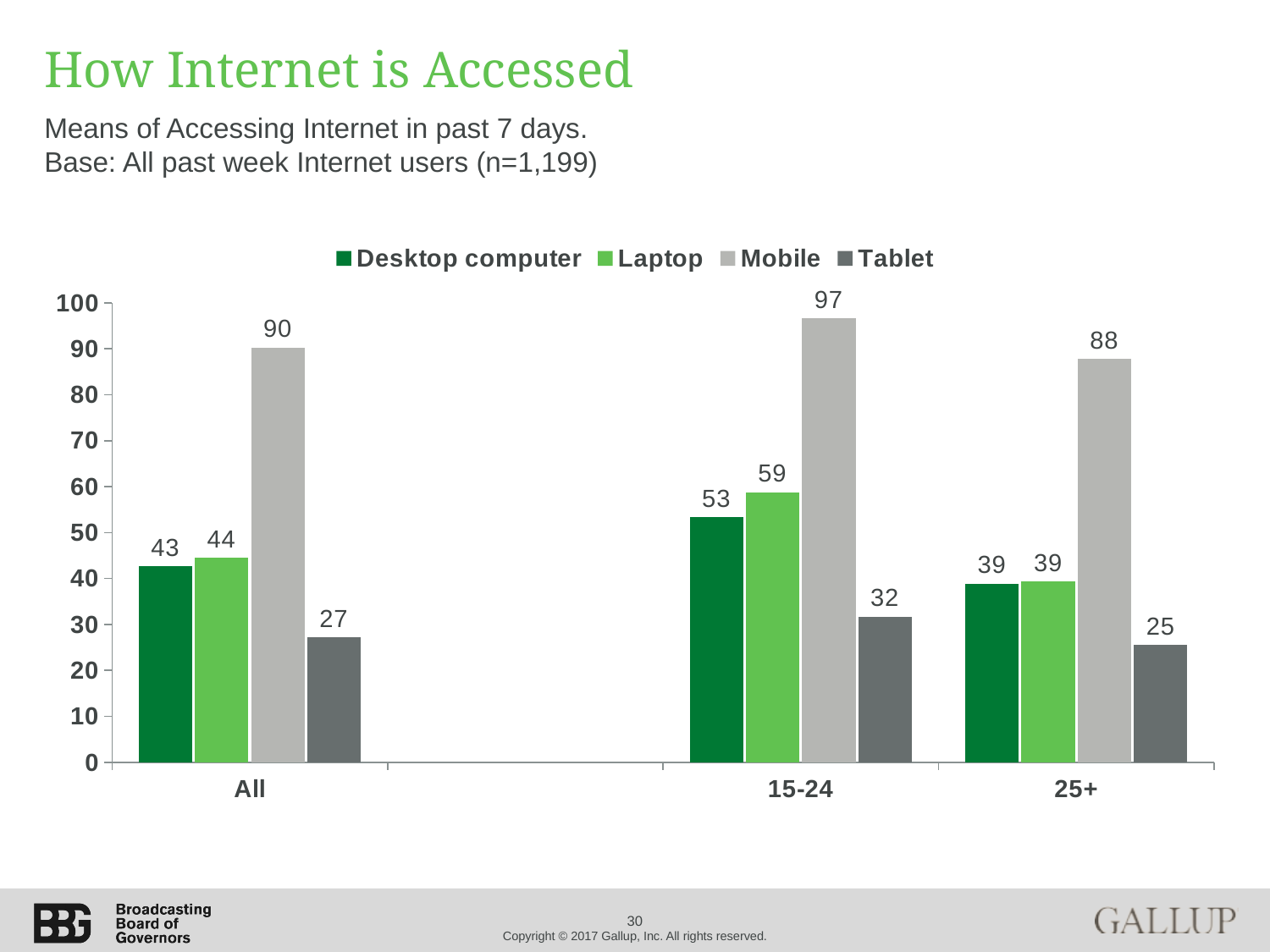
Which series is shown in light grey in the legend? Mobile Which means of access has the lowest value in the 25+ group? Tablet Which means of access has the highest value in the All group? Mobile How many series does the legend list? 4 What is the difference between the Mobile values for 15-24 and 25+? 9 What is the value for Mobile in the 15-24 group? 97 How many groups are shown on the x axis? 3 Which is larger, the Laptop value for 15-24 or the Laptop value for 25+? 15-24 What is the value for Tablet in the All group? 27 What is the value for Laptop in the 25+ group? 39 What kind of chart is shown on the slide? Bar chart What is the difference between the Desktop computer and Laptop values in the 15-24 group? 6